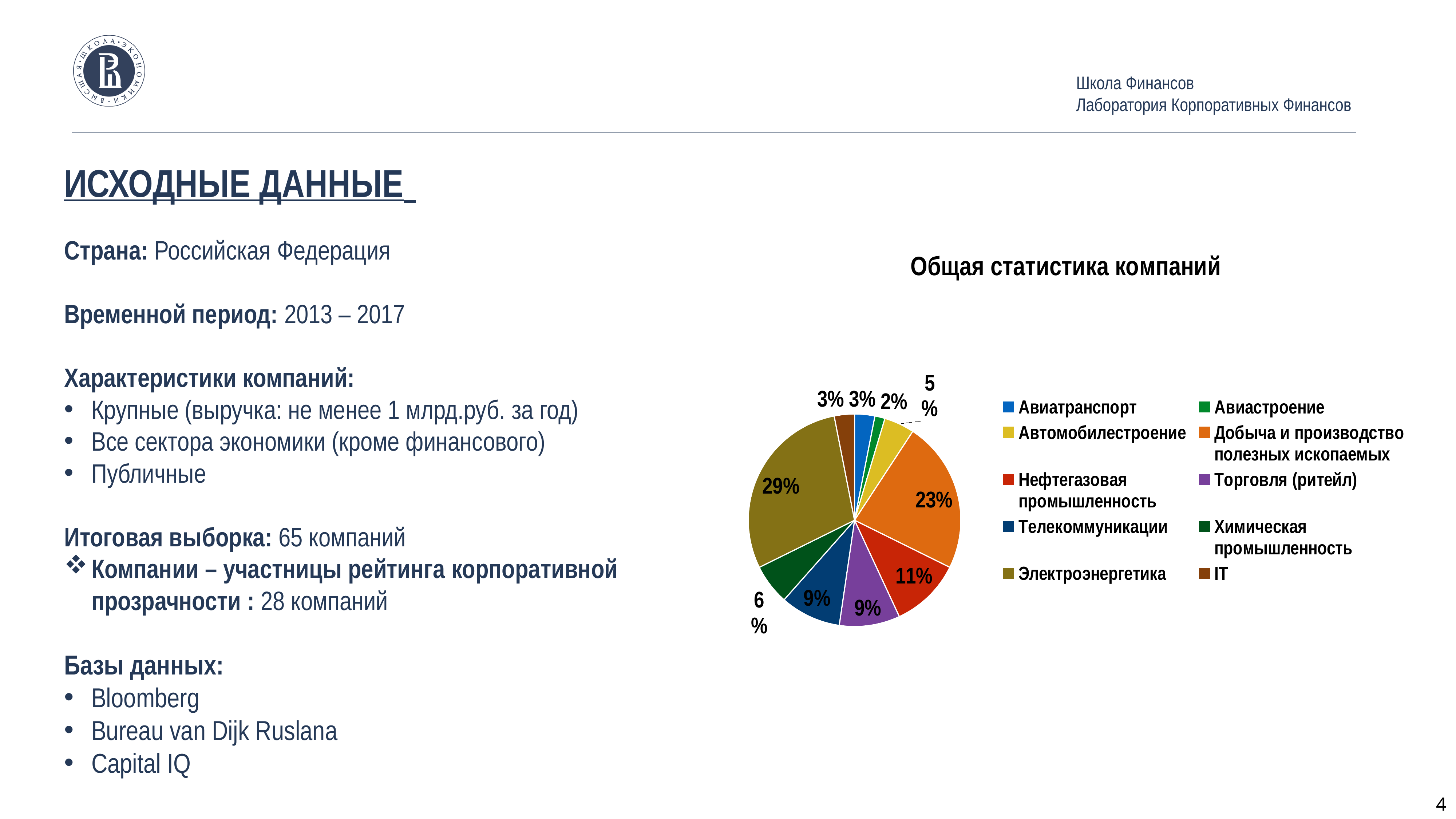
Which category has the largest share of the pie? Электроэнергетика What kind of chart is shown on the slide? pie chart How many categories does the pie chart's legend list? 10 What share of the pie does Электроэнергетика have? 29% What is the value for Химическая промышленность? 6% What share of the pie does Добыча и производство полезных ископаемых have? 23% Which category has the smallest share of the pie? Авиастроение What is the difference between the shares of Электроэнергетика and Добыча и производство полезных ископаемых? 6% Which is larger, the share for Нефтегазовая промышленность or the share for Торговля (ритейл)? Нефтегазовая промышленность What is the title of the chart? Общая статистика компаний What is the value for Нефтегазовая промышленность? 11% What is the value for Автомобилестроение? 5%